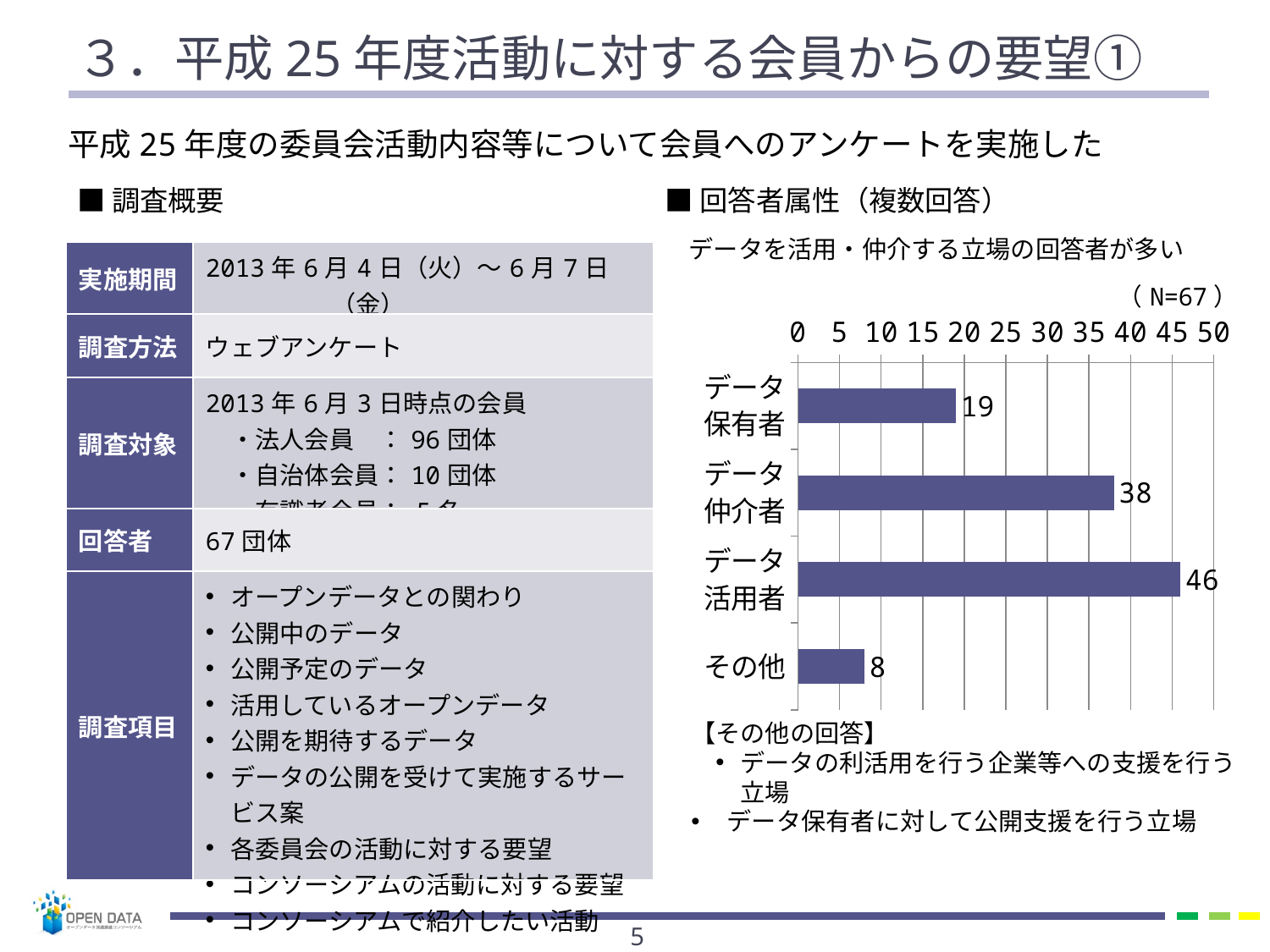
How many categories are shown in the bar chart? 4 What is the difference between the values for データ活用者 and データ仲介者? 8 What is the difference between the values for データ仲介者 and データ保有者? 19 What is the value for データ保有者 in the bar chart? 19 Which category has the highest value in the bar chart? データ活用者 Which is larger, the value for データ保有者 or the value for その他? データ保有者 What is the value for その他 in the bar chart? 8 What is the value for データ活用者 in the bar chart? 46 Which category has the lowest value in the bar chart? その他 What is the N value shown above the bar chart? N=67 What kind of chart is shown on the slide? bar chart What is the value for データ仲介者 in the bar chart? 38